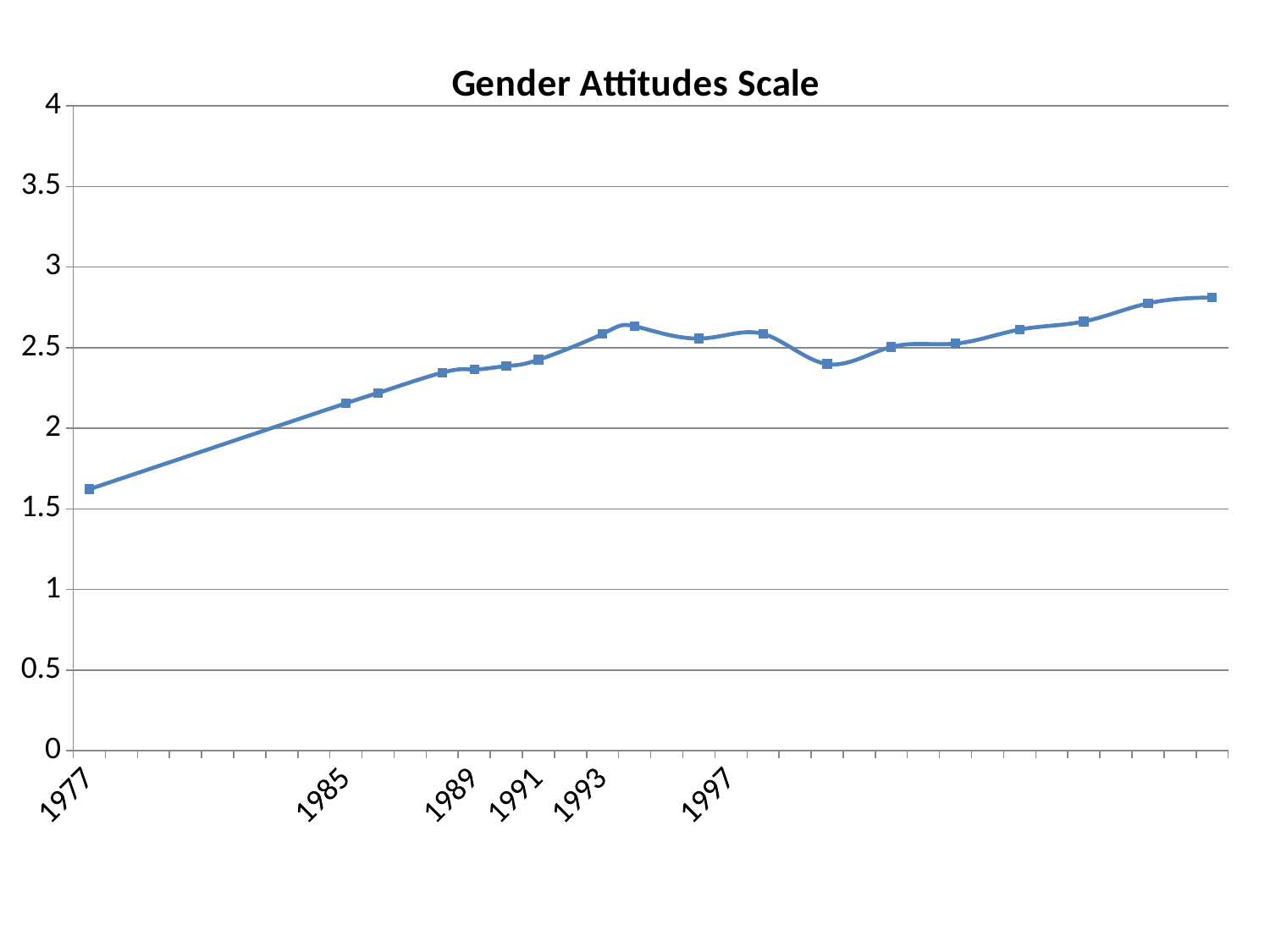
What kind of chart is shown on the slide? line chart Is the value for 1985 greater or less than 2? greater Overall, do the values rise or fall from 1977 to the end of the series? rise Which is larger, the value for 1977 or the value for 1985? 1985 What is the title of the chart? Gender Attitudes Scale Is the value for 1991 greater or less than 3? less Is the value for 1993 greater or less than 2.5? greater What is the highest value shown on the vertical axis? 4 Which labelled year has the lowest value on the chart? 1977 Which is larger, the value for 1989 or the value for 1993? 1993